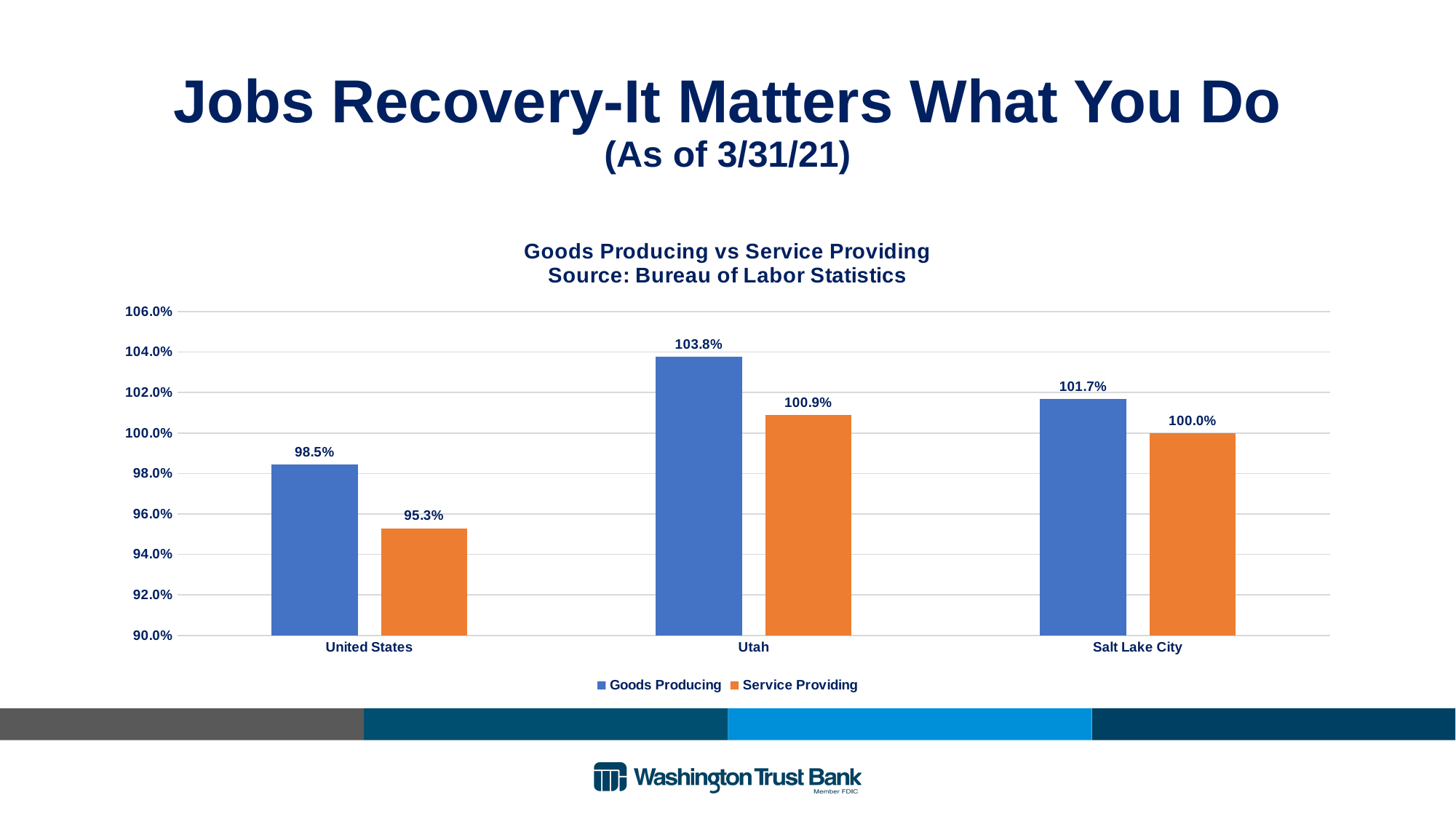
What is the difference between the Goods Producing values for Utah and Salt Lake City? 2.1% How many series does the legend list? 2 Which category has the highest Goods Producing value? Utah What kind of chart is shown on the slide? Bar chart What is the Service Providing value for the United States? 95.3% How many categories are shown on the x axis? 3 Which is larger: the Service Providing value for Utah or for Salt Lake City? Utah What is the Service Providing value for Salt Lake City? 100.0% What is the difference between the Goods Producing and Service Providing values for the United States? 3.2% What is the Goods Producing value for Utah? 103.8% Is the Goods Producing value for the United States greater or less than 100.0%? less Which category has the lowest Service Providing value? United States